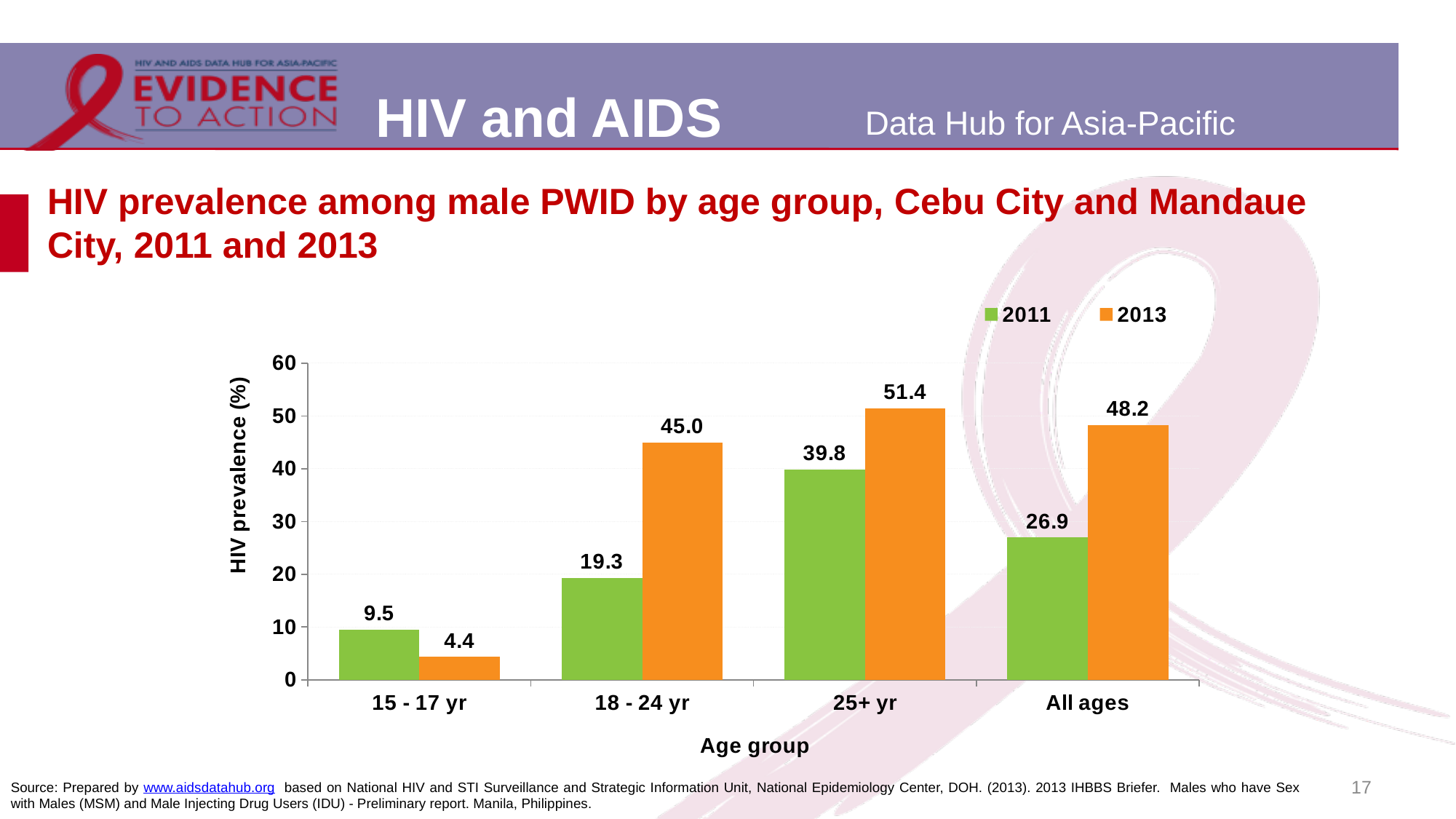
Is the 2011 HIV prevalence for the 25+ yr age group greater or less than 30? greater Which year had the higher HIV prevalence for the 15 - 17 yr age group, 2011 or 2013? 2011 What was the HIV prevalence for All ages in 2013? 48.2 How many age group categories are shown on the x axis? 4 What was the HIV prevalence among male PWID aged 18 - 24 yr in 2013? 45.0 What kind of chart is shown on the slide? Bar chart What was the HIV prevalence among male PWID aged 15 - 17 yr in 2011? 9.5 Which age group had the highest HIV prevalence in 2013? 25+ yr What is the label of the y axis? HIV prevalence (%) How many series does the legend list? 2 Which age group had the lowest HIV prevalence in 2011? 15 - 17 yr What is the difference between the 2013 and 2011 HIV prevalence for the 18 - 24 yr age group? 25.7